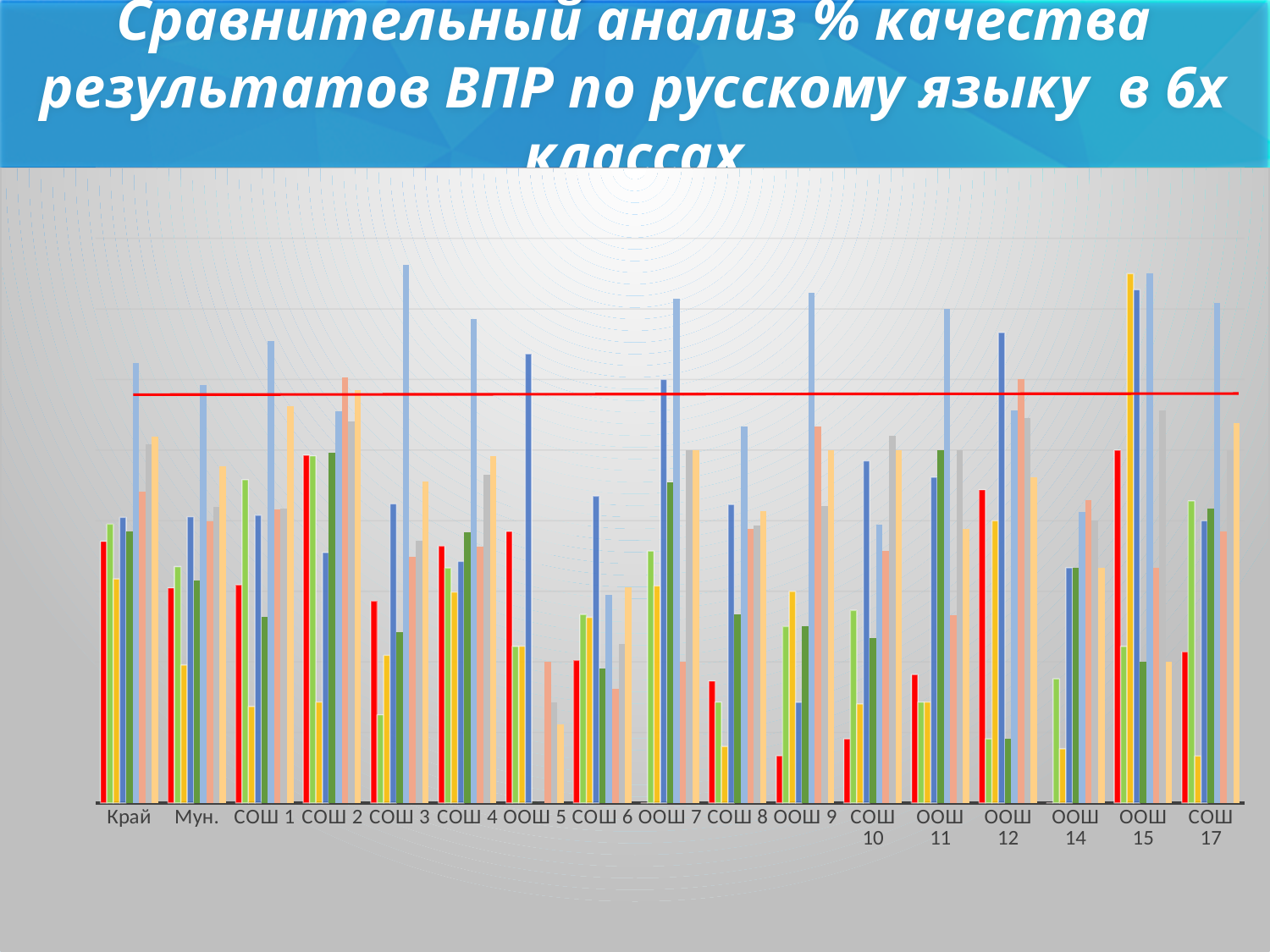
Which is taller, the red bar for ООШ 15 or the red bar for ООШ 9? ООШ 15 Which is taller, the red bar for СОШ 2 or the red bar for СОШ 10? СОШ 2 What is the first category label on the x axis of the chart? Край How many categories are shown along the x axis of the chart? 17 What kind of chart is shown on the slide? bar chart What is the title of the chart on the slide? Сравнительный анализ % качества результатов ВПР по русскому языку в 6х классах Which is taller, the red bar for ООШ 12 or the red bar for СОШ 8? ООШ 12